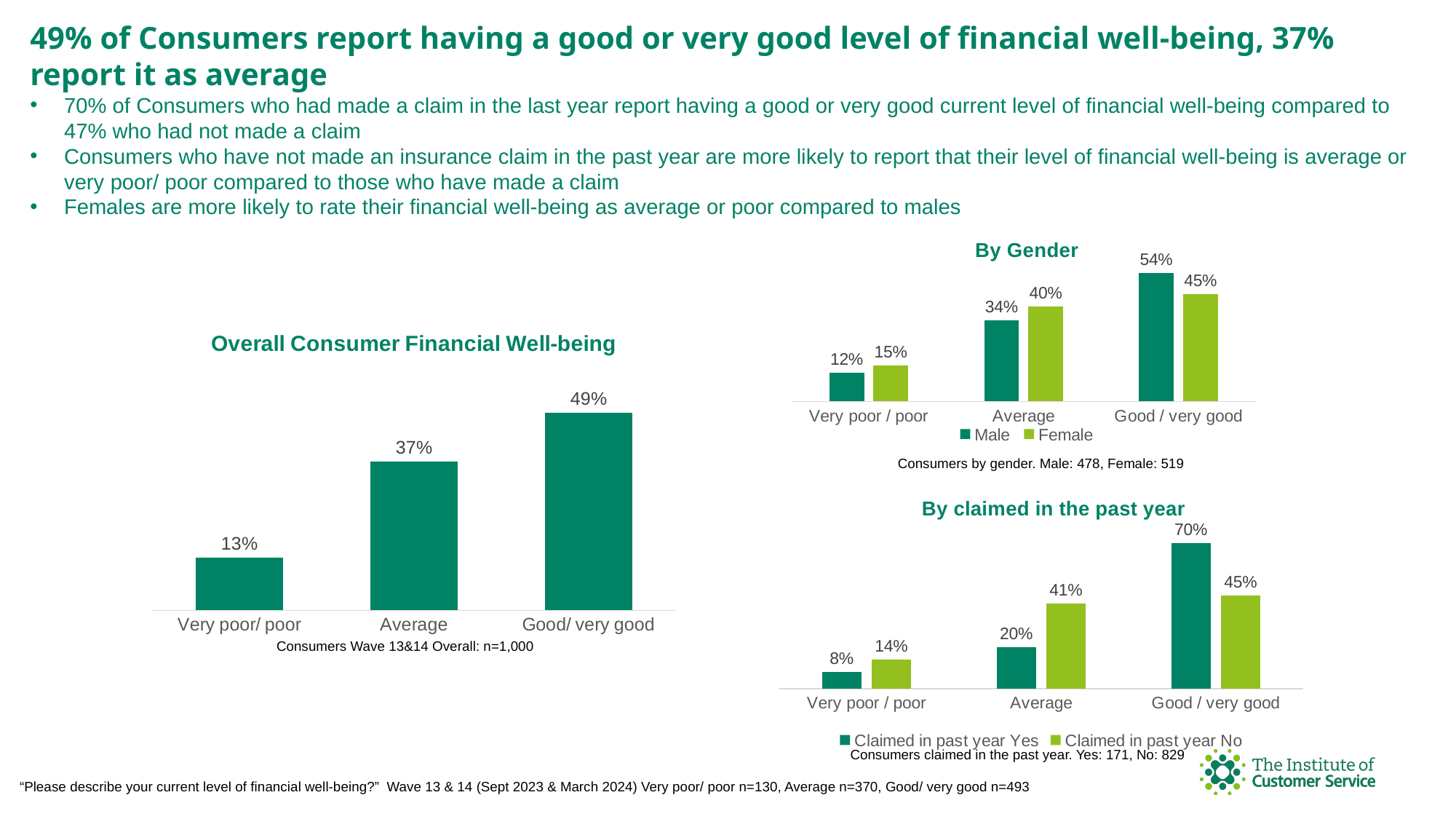
In the 'By claimed in the past year' chart, what is the difference between Claimed in past year Yes and Claimed in past year No for Good / very good? 25% What kind of chart is the 'By claimed in the past year' chart? Bar chart In the 'By Gender' chart, what is the Male value for Good / very good? 54% In the 'By claimed in the past year' chart, what is the value for Claimed in past year No for Average? 41% In the 'Overall Consumer Financial Well-being' chart, which category has the lowest value? Very poor/ poor In the 'Overall Consumer Financial Well-being' chart, how many categories are shown? 3 In the 'Overall Consumer Financial Well-being' chart, what is the difference between Good/ very good and Very poor/ poor? 36% In the 'By Gender' chart, how many series does the legend list? 2 In the 'Overall Consumer Financial Well-being' chart, what is the value for Average? 37% In the 'By Gender' chart, which is larger for Very poor / poor: Male or Female? Female In the 'By Gender' chart, what is the Female value for Average? 40% In the 'By claimed in the past year' chart, do the Claimed in past year Yes values rise or fall from Very poor / poor to Good / very good? Rise